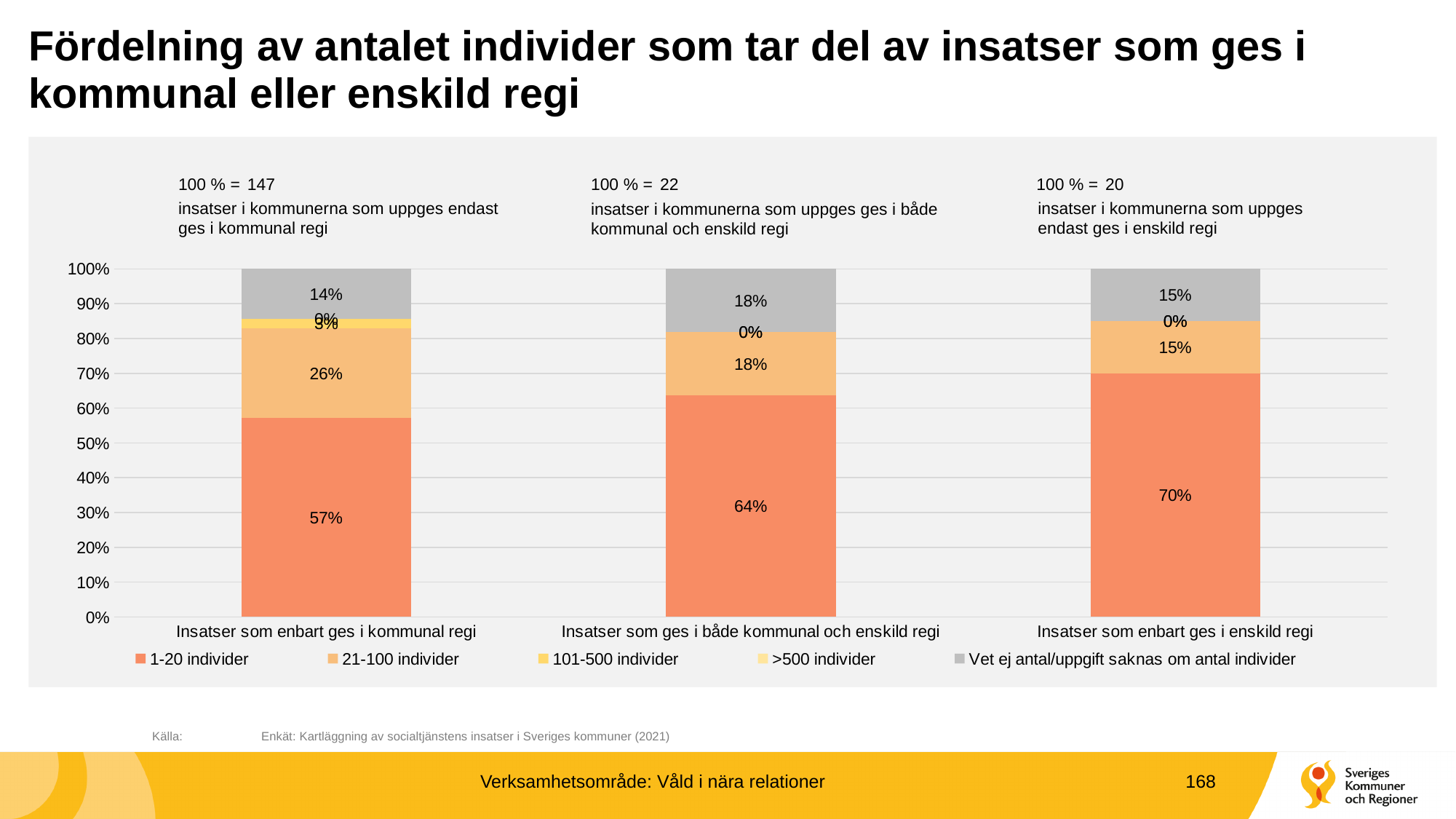
Which category has the largest '1-20 individer' share? Insatser som enbart ges i enskild regi What is the 'Vet ej antal/uppgift saknas om antal individer' share for 'Insatser som ges i både kommunal och enskild regi'? 18% Which has a larger '21-100 individer' share: 'Insatser som enbart ges i kommunal regi' or 'Insatser som enbart ges i enskild regi'? Insatser som enbart ges i kommunal regi What is the '21-100 individer' share for 'Insatser som ges i både kommunal och enskild regi'? 18% How many categories are shown on the x axis? 3 What percentage of 'Insatser som enbart ges i kommunal regi' falls in the '1-20 individer' segment? 57% What is the '1-20 individer' share for 'Insatser som enbart ges i enskild regi'? 70% How many series does the legend list? 5 What kind of chart is shown on the slide? Stacked bar chart According to the note above the chart, how many insatser does 100 % correspond to for insatser that are only given in kommunal regi? 147 What is the difference in the '1-20 individer' share between 'Insatser som enbart ges i enskild regi' and 'Insatser som enbart ges i kommunal regi'? 13 percentage points Is the '1-20 individer' share for 'Insatser som ges i både kommunal och enskild regi' greater or less than 60%? greater